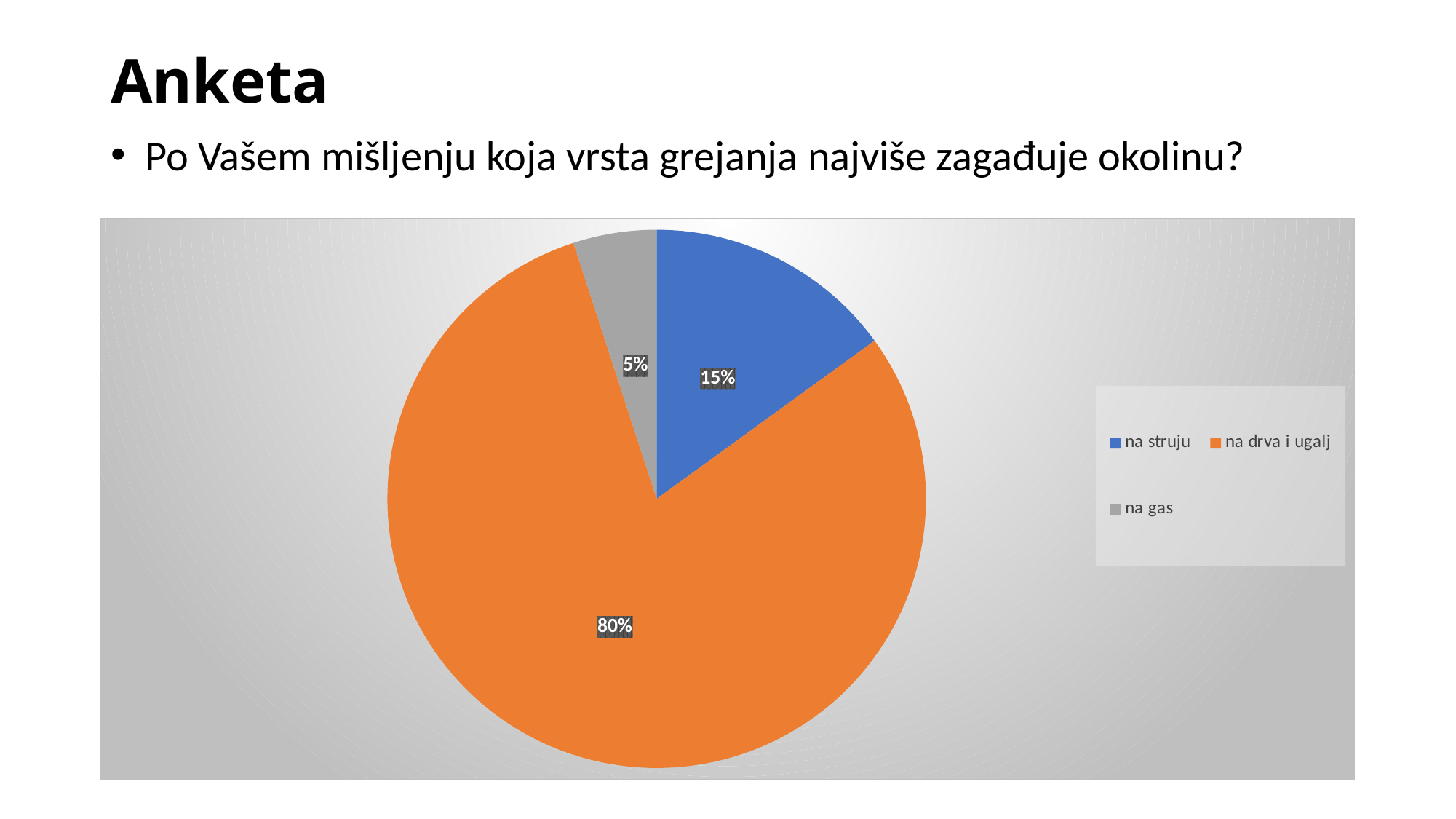
What share of the pie does "na drva i ugalj" have? 80% What is the difference in percentage points between "na drva i ugalj" and "na struju"? 65 What colour is the slice for "na gas"? grey What kind of chart is shown on the slide? pie chart Which category has the largest slice of the pie? na drva i ugalj How many slices does the pie chart have? 3 What is the difference in percentage points between "na struju" and "na gas"? 10 Which is larger, the slice for "na struju" or the slice for "na gas"? na struju Which category has the smallest slice of the pie? na gas What share of the pie does "na gas" have? 5% What share of the pie does "na struju" have? 15% How many entries does the legend list? 3